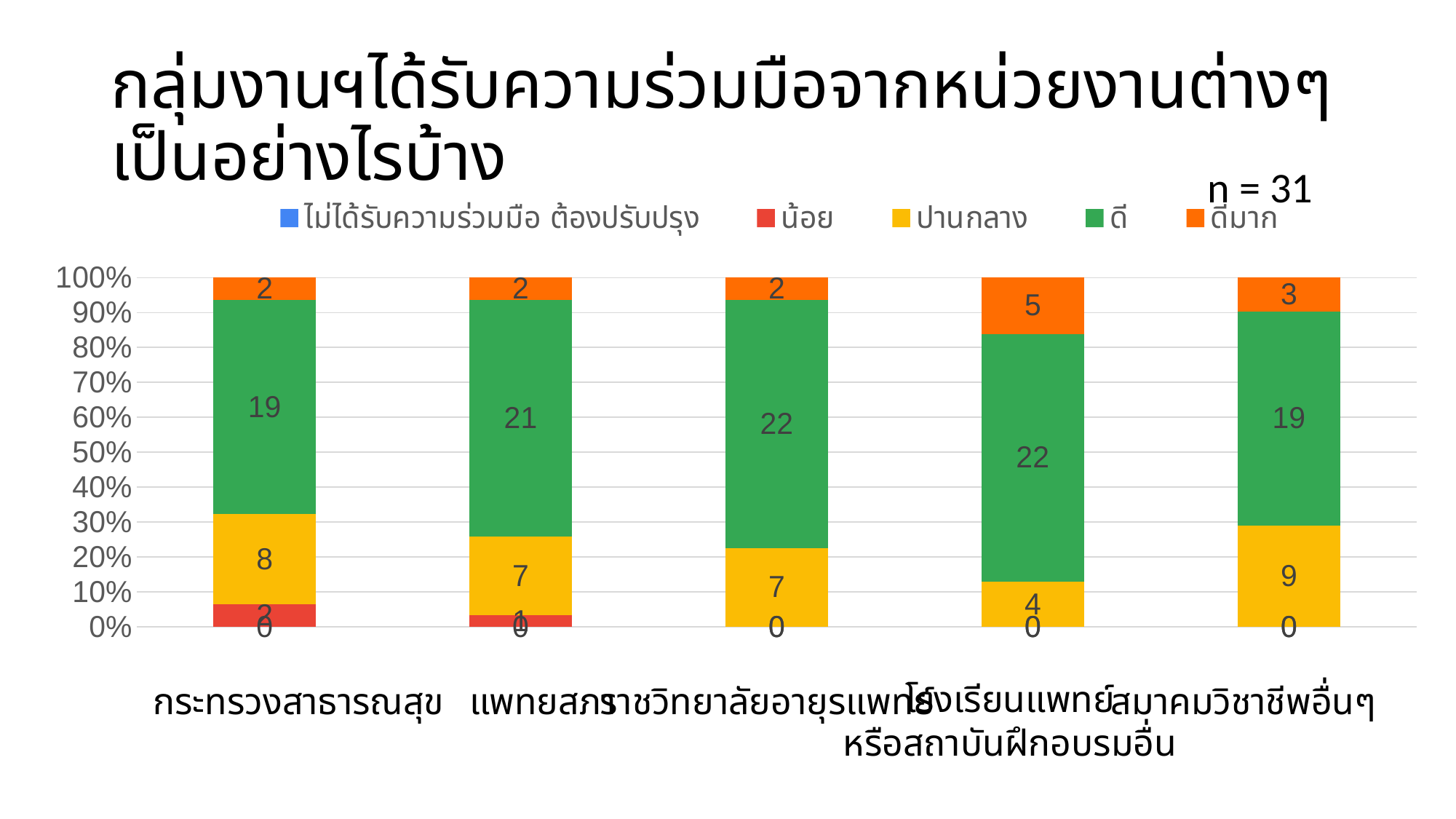
What is the value of the ดี segment for แพทยสภา? 21 What is the value of the ดี segment for กระทรวงสาธารณสุข? 19 What is the difference between the ดี values for ราชวิทยาลัยอายุรแพทย์ and สมาคมวิชาชีพอื่นๆ? 3 What is the value of the ดีมาก segment for โรงเรียนแพทย์หรือสถาบันฝึกอบรมอื่น? 5 Which category has the lowest ปานกลาง value? โรงเรียนแพทย์หรือสถาบันฝึกอบรมอื่น What kind of chart is shown on the slide? stacked bar chart How many series does the legend list? 5 What sample size (n) is stated on the slide? n = 31 What is the value of the ปานกลาง segment for สมาคมวิชาชีพอื่นๆ? 9 Which category has the highest ดีมาก value? โรงเรียนแพทย์หรือสถาบันฝึกอบรมอื่น Which is larger, the ปานกลาง value for กระทรวงสาธารณสุข or for แพทยสภา? กระทรวงสาธารณสุข How many categories are shown on the x axis? 5